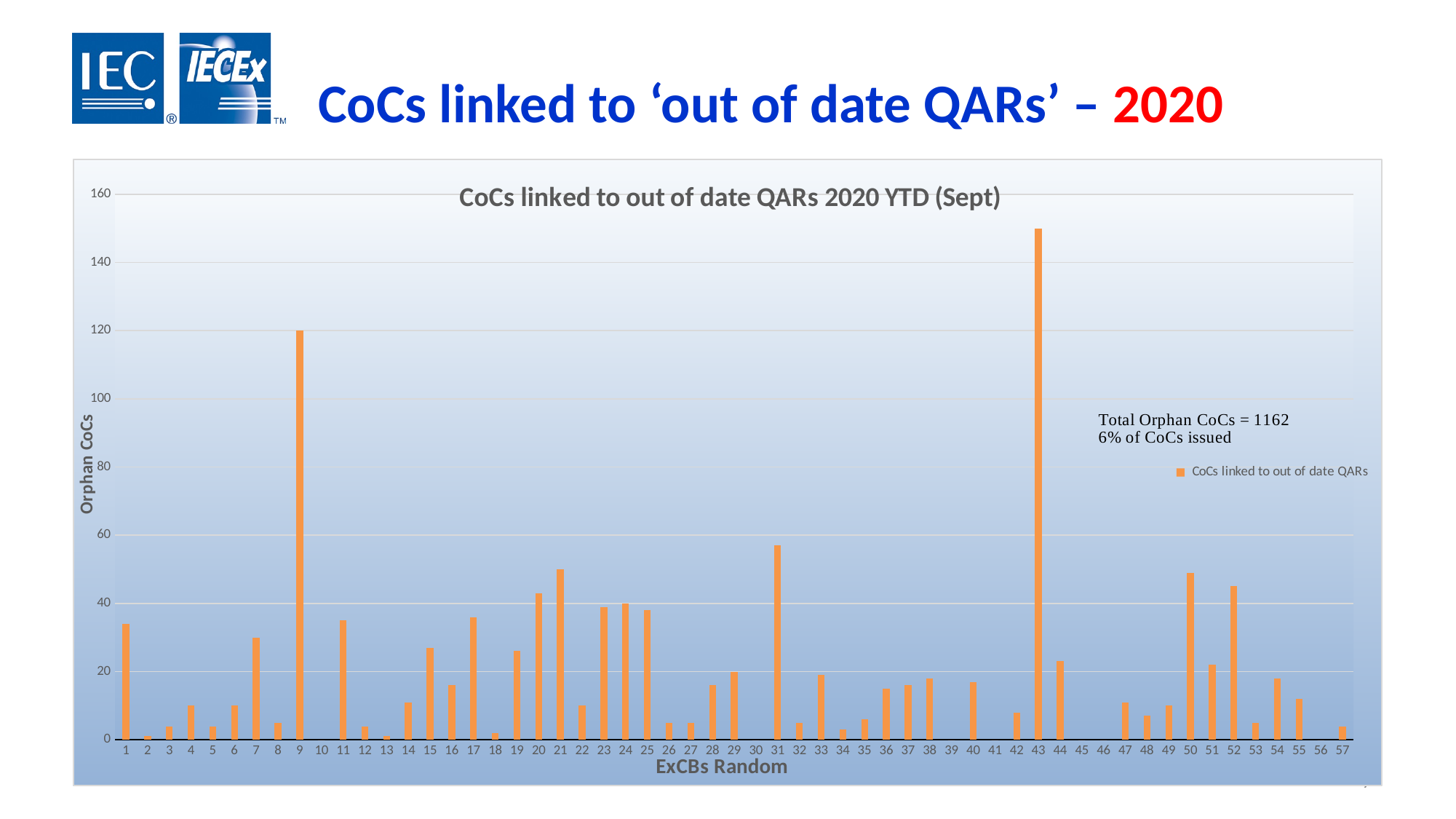
What total number of orphan CoCs is stated in the chart annotation? 1162 Which has more orphan CoCs, ExCB 9 or ExCB 43? 43 Is the value for ExCB 43 greater or less than 140? greater Is the value for ExCB 11 greater or less than 40? less How many ExCB categories are plotted along the x axis? 57 Which has more orphan CoCs, ExCB 21 or ExCB 31? 31 Is the value for ExCB 1 greater or less than 20? greater What is the value for ExCB 9? 120 What kind of chart is shown on the slide? bar chart What is the title of the chart? CoCs linked to out of date QARs 2020 YTD (Sept) How many series does the legend list? 1 Which ExCB has the highest number of orphan CoCs? 43